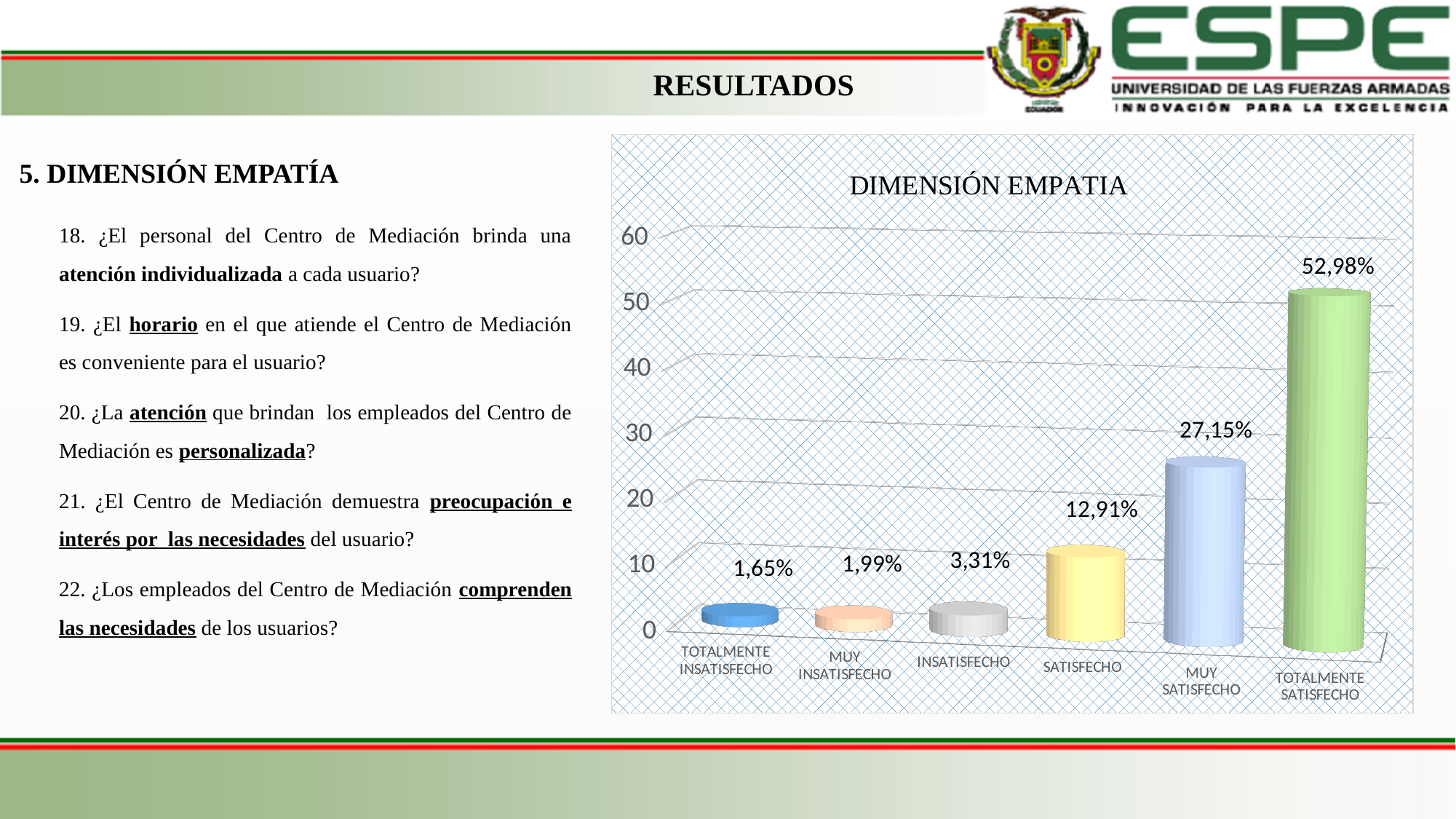
What is the value for TOTALMENTE INSATISFECHO? 1,65% Which is larger, the value for SATISFECHO or the value for INSATISFECHO? SATISFECHO What is the value for SATISFECHO? 12,91% What is the difference between the values for TOTALMENTE SATISFECHO and MUY SATISFECHO? 25,83% What is the value for MUY SATISFECHO? 27,15% What is the value for TOTALMENTE SATISFECHO? 52,98% How many categories are shown on the x axis? 6 What is the value for INSATISFECHO? 3,31% What is the title of the chart? DIMENSIÓN EMPATIA What kind of chart is shown? bar chart Which category has the lowest value? TOTALMENTE INSATISFECHO Which category has the highest value? TOTALMENTE SATISFECHO